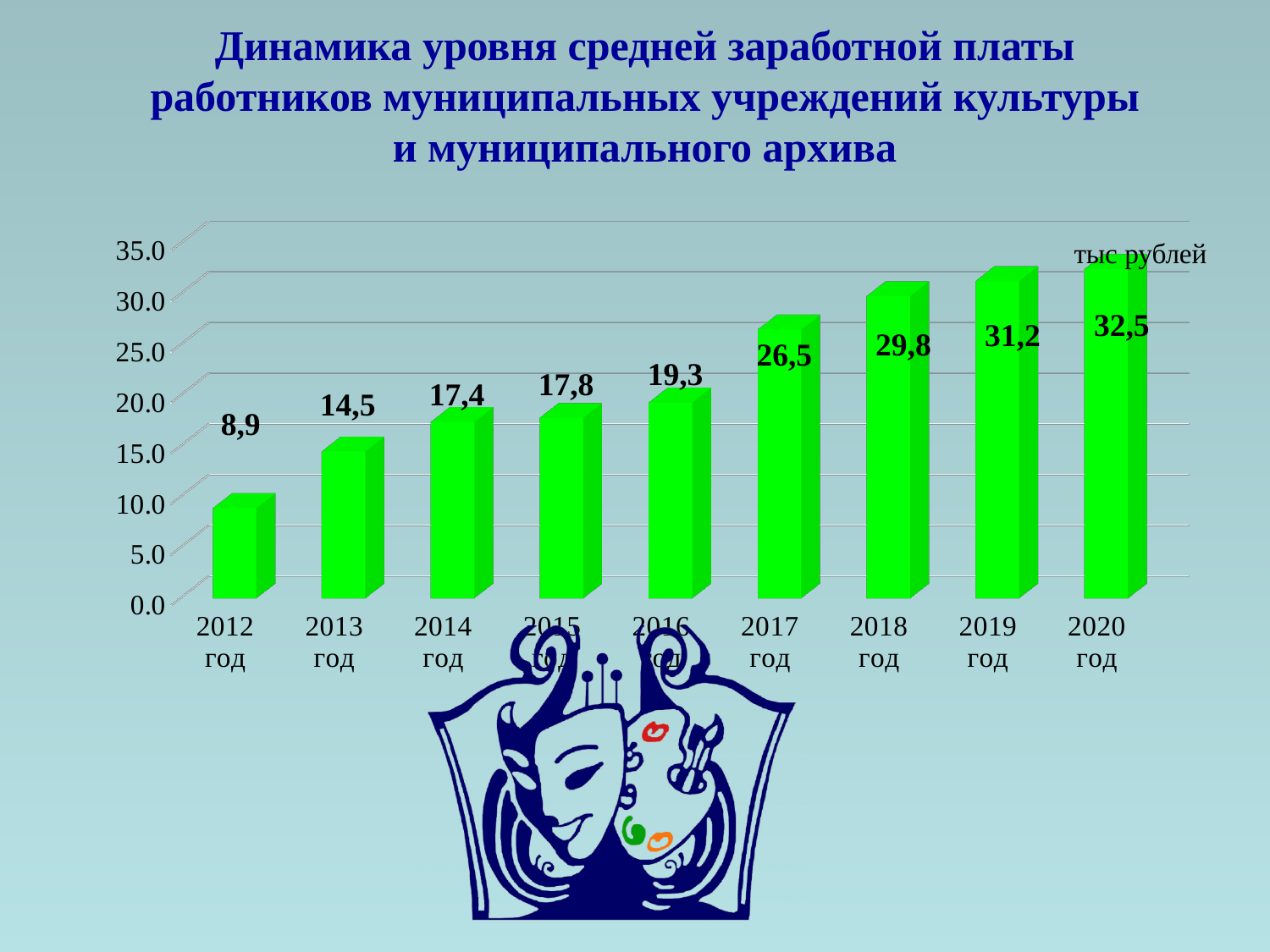
Is the value for 2018 год greater or less than 25.0? greater What is the difference between the values for 2020 год and 2012 год? 23,6 What is the value for 2019 год? 31,2 Do the values rise or fall from 2012 год to 2020 год? rise What is the difference between the values for 2018 год and 2017 год? 3,3 What is the value for 2017 год? 26,5 How many years are shown on the x axis? 9 Which is larger, the value for 2016 год or the value for 2017 год? 2017 год Which year has the lowest value? 2012 год What is the value for 2012 год? 8,9 Which year has the highest value? 2020 год What kind of chart is shown on the slide? bar chart